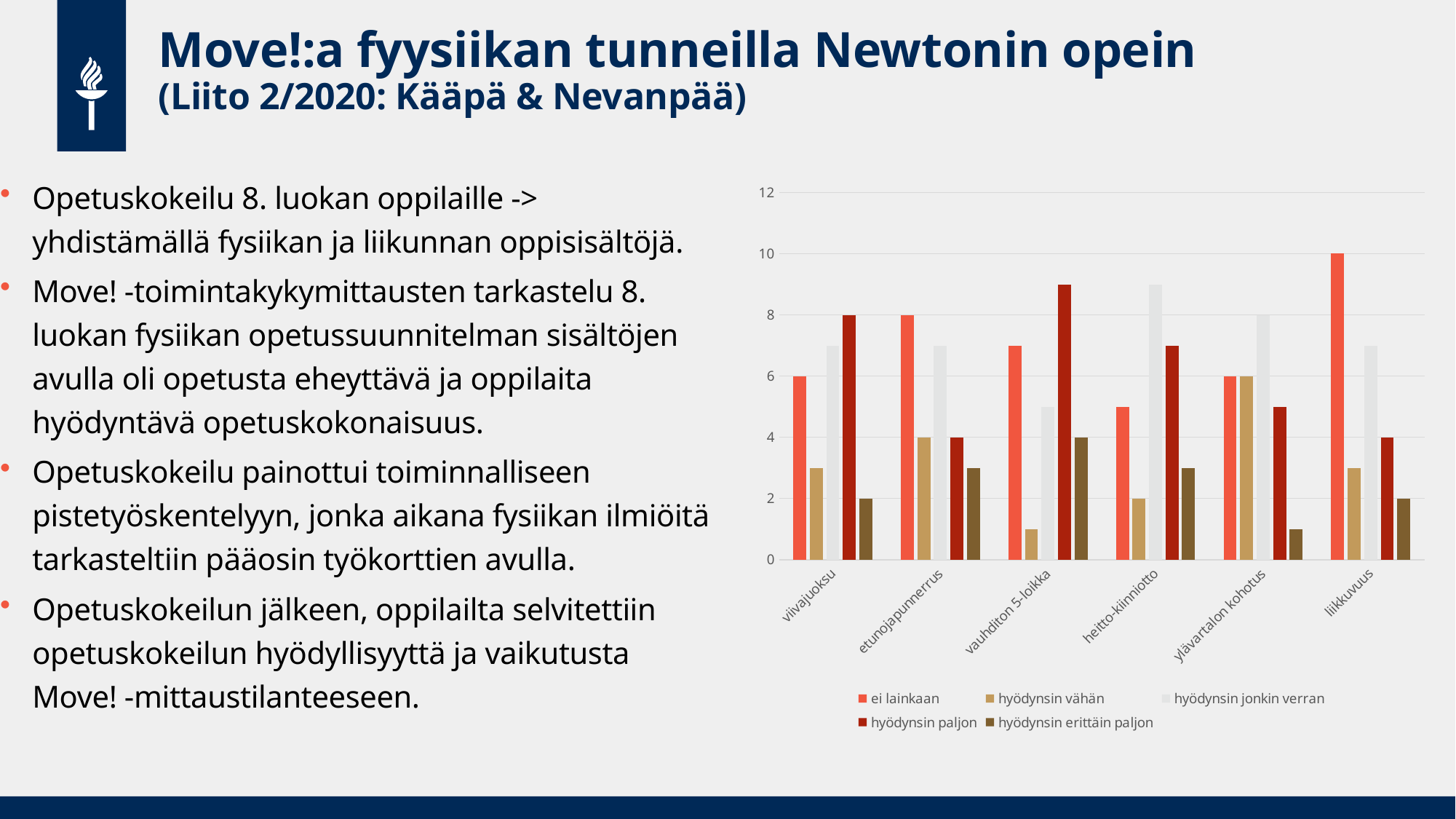
Is the 'hyödynsin paljon' value for vauhditon 5-loikka greater or less than 8? greater What is the difference between the 'ei lainkaan' values for liikkuvuus and viivajuoksu? 4 How many categories are shown on the x axis of the chart? 6 What is the value of 'hyödynsin paljon' for viivajuoksu? 8 For which category is the 'hyödynsin erittäin paljon' value lowest? ylävartalon kohotus What is the value of 'hyödynsin jonkin verran' for ylävartalon kohotus? 8 What is the value of 'hyödynsin vähän' for heitto-kiinniotto? 2 Which is larger: the 'ei lainkaan' value for etunojapunnerrus or for heitto-kiinniotto? etunojapunnerrus What is the value of 'ei lainkaan' for liikkuvuus? 10 For which category is the 'ei lainkaan' value highest? liikkuvuus How many series does the chart legend list? 5 What type of chart is shown on the slide? bar chart